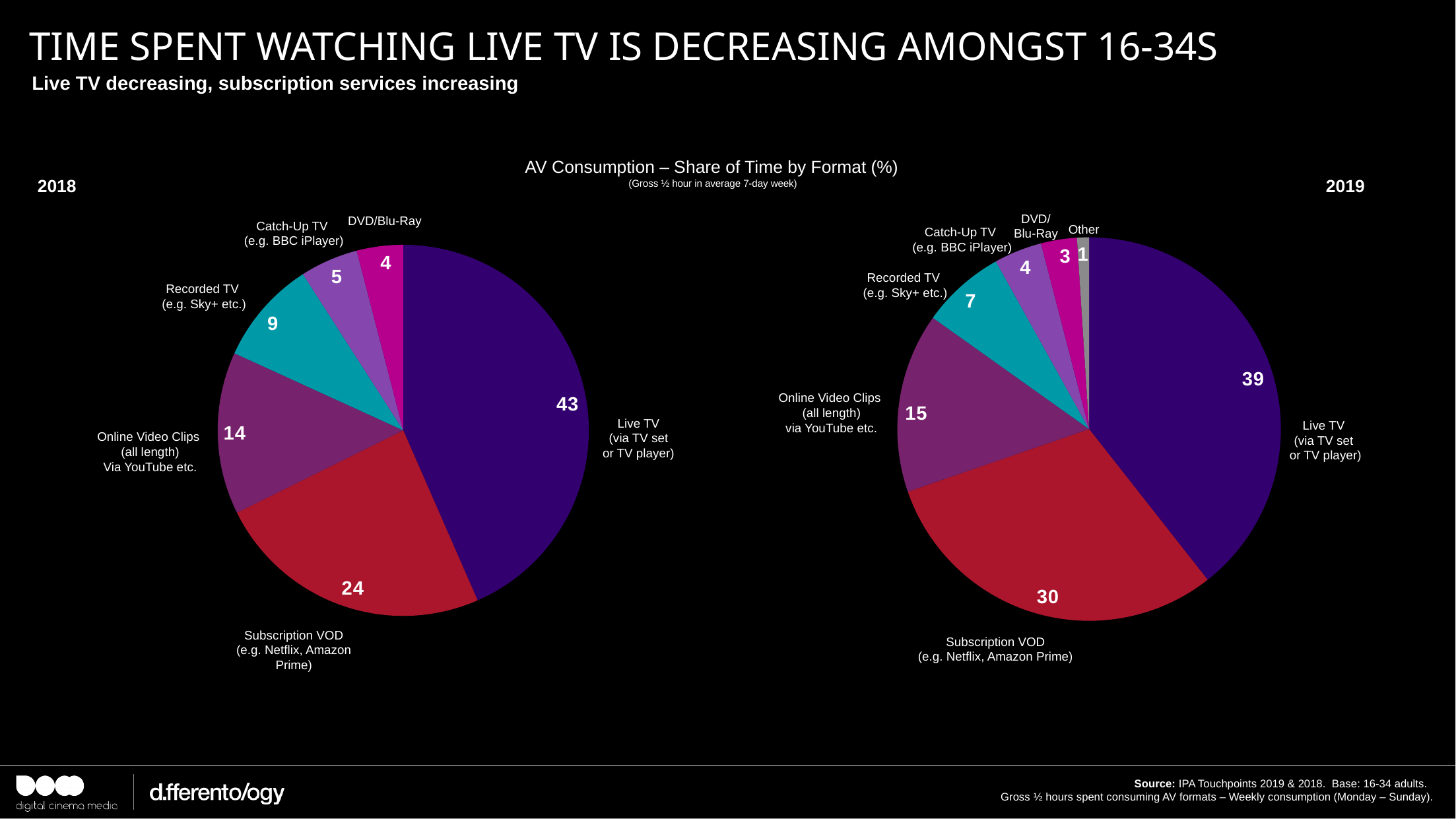
In the 2018 pie chart, what is the share for Live TV (via TV set or TV player)? 43 In the 2019 pie chart, what is the share for Recorded TV (e.g. Sky+ etc.)? 7 In the 2019 pie chart, what is the share for Subscription VOD (e.g. Netflix, Amazon Prime)? 30 How many slices does the 2019 pie chart have? 7 How many slices does the 2018 pie chart have? 6 In the 2019 pie chart, what is the difference between Subscription VOD and Online Video Clips? 15 In the 2018 pie chart, which format has the smallest share? DVD/Blu-Ray In the 2019 pie chart, which format has the smallest share? Other In the 2018 pie chart, which format has the largest share? Live TV (via TV set or TV player) What is the difference between the Live TV share in 2018 and in 2019? 4 What type of chart is used on this slide? Pie chart Which is larger: Online Video Clips in 2018 or Online Video Clips in 2019? 2019